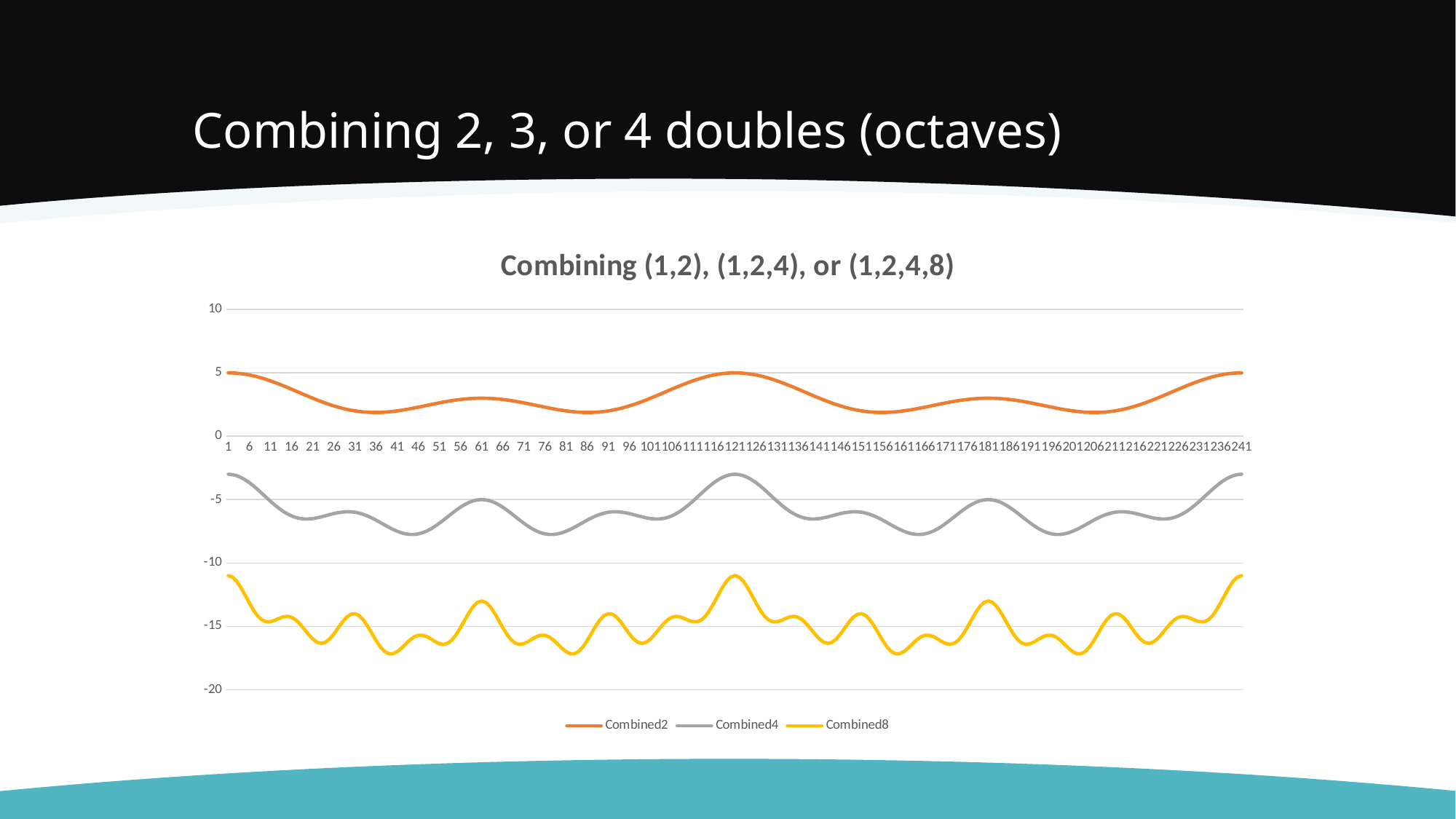
At x = 121, which series has the larger value, Combined2 or Combined4? Combined2 How many series does the legend list? 3 Does the Combined2 line rise or fall between x = 86 and x = 121? rise Is the value of Combined8 at x = 121 greater or less than -5? less Does the Combined2 line rise or fall between x = 1 and x = 36? fall Which series has the highest values across the chart? Combined2 Is the value of Combined4 at x = 121 greater or less than -10? greater What is the title of the chart? Combining (1,2), (1,2,4), or (1,2,4,8) Is the value of Combined2 at x = 1 greater or less than 0? greater What kind of chart is shown on the slide? line chart Which series is drawn in orange? Combined2 Which series has the lowest values across the chart? Combined8